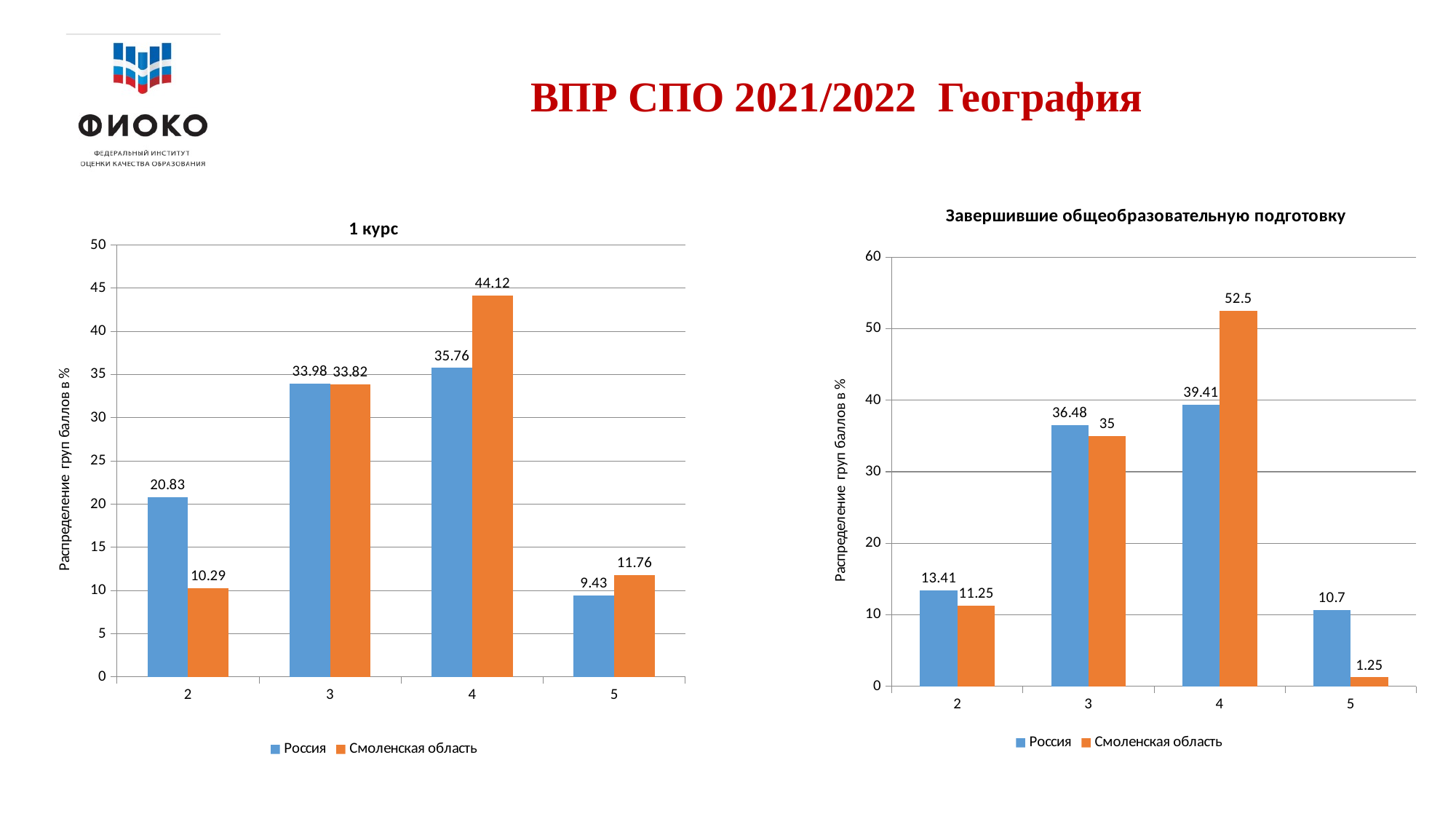
In the '1 курс' chart, what is the value for Россия for score group 2? 20.83 In the 'Завершившие общеобразовательную подготовку' chart, which is larger for score group 4: Россия or Смоленская область? Смоленская область In the '1 курс' chart, which score group has the highest value for Смоленская область? 4 In the 'Завершившие общеобразовательную подготовку' chart, what is the difference between Смоленская область and Россия for score group 4? 13.09 In the 'Завершившие общеобразовательную подготовку' chart, what is the value for Смоленская область for score group 5? 1.25 In the '1 курс' chart, what is the value for Смоленская область for score group 4? 44.12 What kind of chart is the '1 курс' chart? Bar chart In the 'Завершившие общеобразовательную подготовку' chart, how many score groups are shown on the x axis? 4 In the 'Завершившие общеобразовательную подготовку' chart, what is the value for Россия for score group 3? 36.48 In the '1 курс' chart, what is the difference between Россия and Смоленская область for score group 2? 10.54 In the '1 курс' chart, which score group has the lowest value for Россия? 5 In the '1 курс' chart, how many series does the legend list? 2